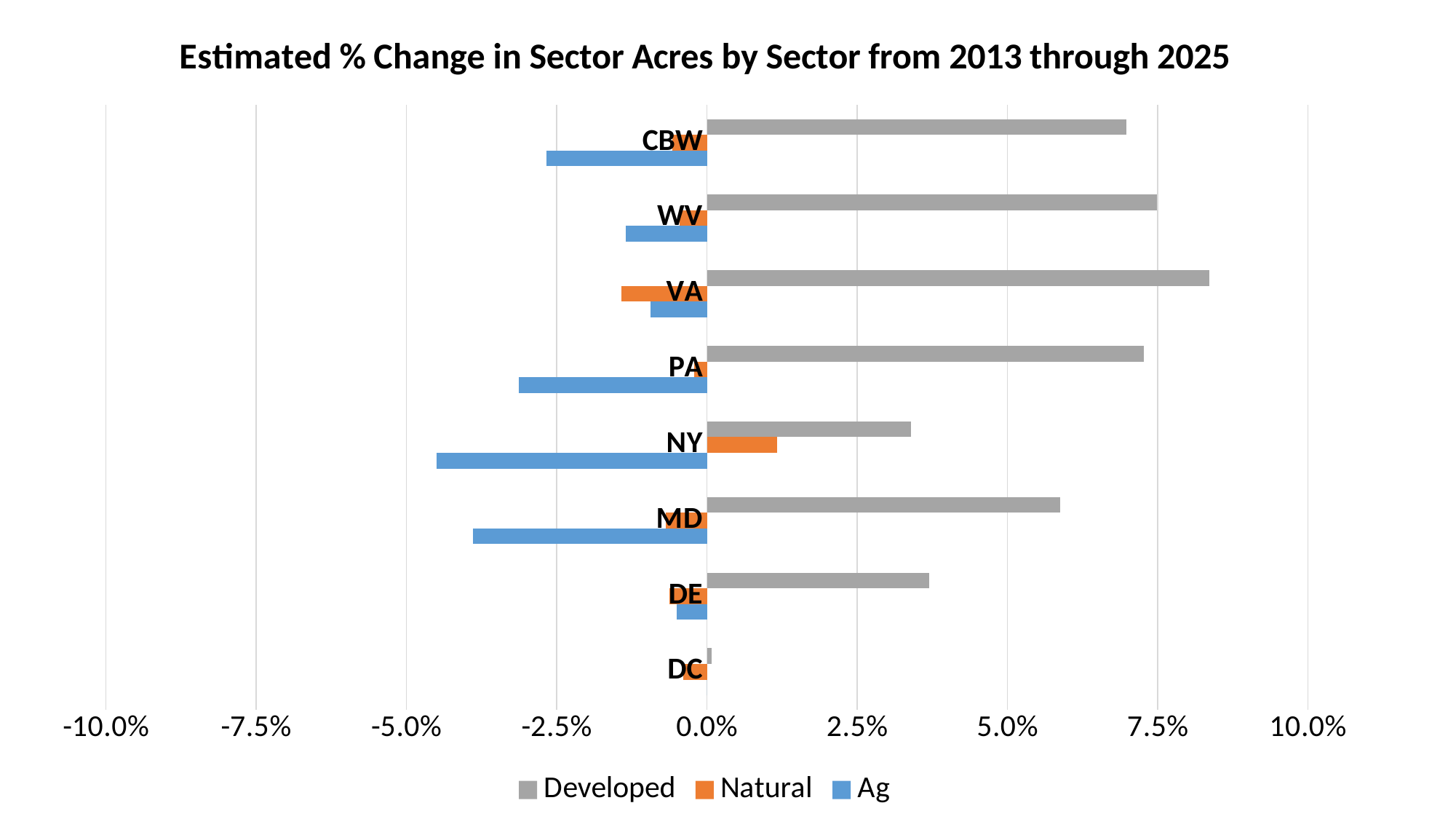
How many categories (jurisdictions) are plotted on the chart? 8 Which category has the lowest Developed value? DC Which category has the lowest (most negative) Ag value? NY Is the Ag value for NY greater or less than -2.5%? less Which is larger, the Developed value for MD or the Developed value for DE? MD What kind of chart is shown on the slide? bar chart Is the Developed value for VA greater or less than 7.5%? greater How many series does the legend list? 3 Which category has the highest Natural value? NY Which category has the highest Developed value? VA What is the title of the chart? Estimated % Change in Sector Acres by Sector from 2013 through 2025 Is the Developed value for NY greater or less than 5.0%? less